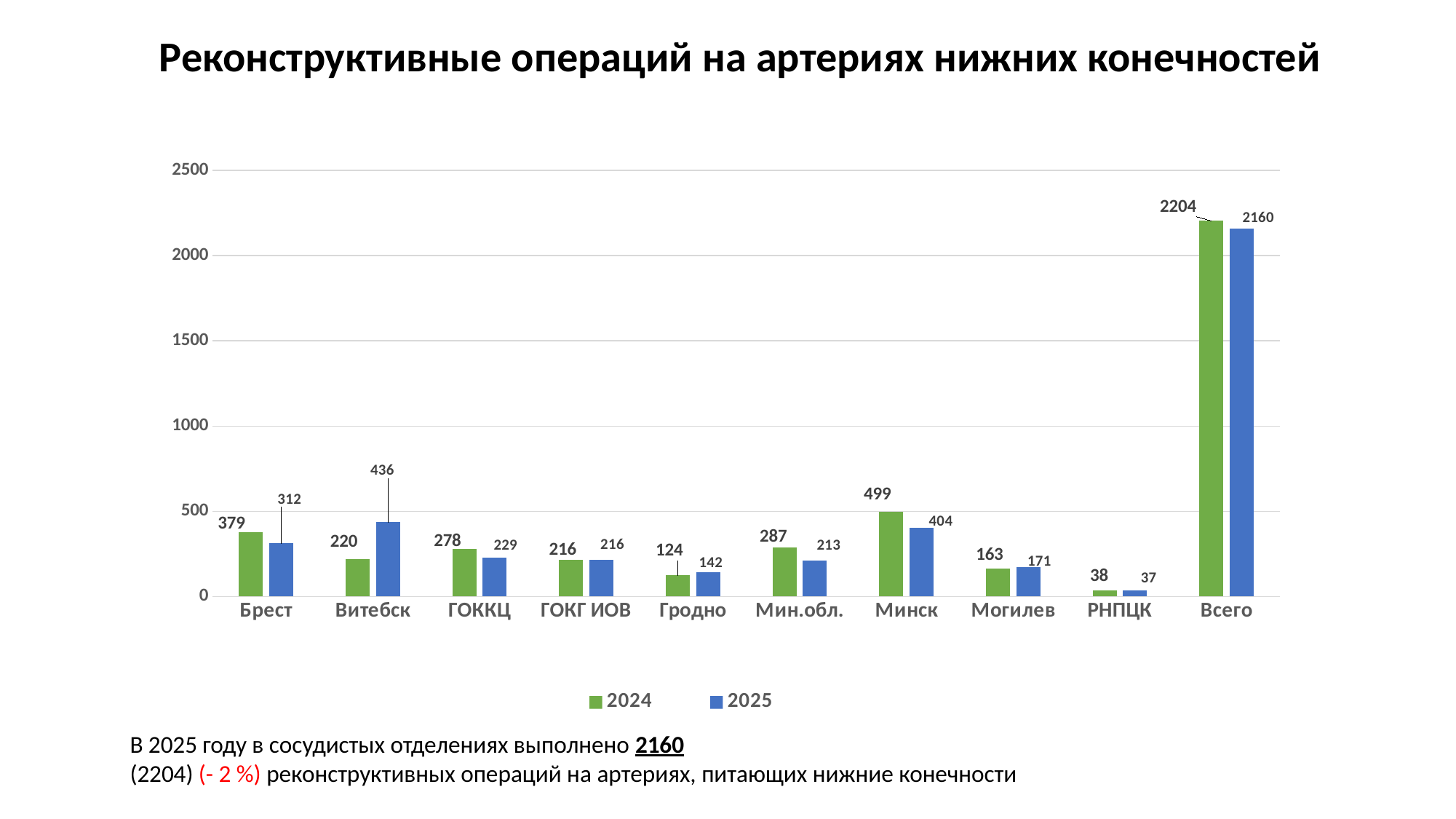
Excluding Всего, which category has the highest value in the 2024 series? Минск What is the value for Всего in the 2025 series? 2160 What is the value for Минск in the 2024 series? 499 How many series does the legend list? 2 What kind of chart is shown on the slide? Bar chart What is the value for Витебск in the 2025 series? 436 For Витебск, which series has the larger value, 2024 or 2025? 2025 How many categories are shown on the x axis? 10 What is the difference between the 2024 and 2025 values for Брест? 67 Which category has the lowest value in the 2025 series? РНПЦК What is the difference between the 2024 and 2025 values for Всего? 44 What is the value for Гродно in the 2024 series? 124